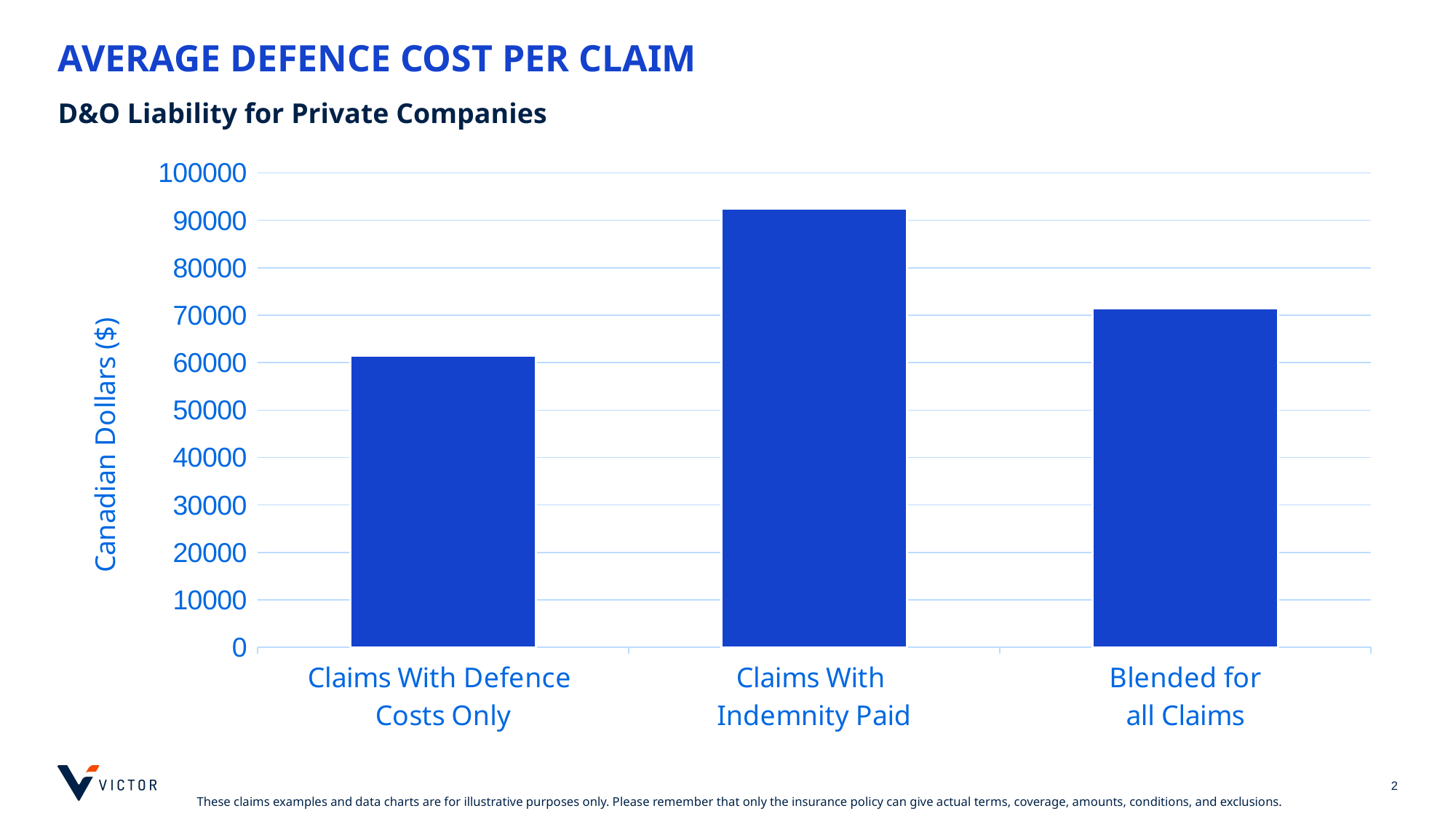
Which category has the lowest average defence cost per claim? Claims With Defence Costs Only Which is larger: the value for Blended for all Claims or the value for Claims With Defence Costs Only? Blended for all Claims What is the title of the chart on the slide? AVERAGE DEFENCE COST PER CLAIM Is the value for Claims With Indemnity Paid greater or less than 80000? greater Which is larger: the value for Claims With Indemnity Paid or the value for Blended for all Claims? Claims With Indemnity Paid Which category has the highest average defence cost per claim? Claims With Indemnity Paid Is the value for Claims With Defence Costs Only greater or less than 70000? less How many categories are plotted in the chart? 3 What is the label of the vertical axis? Canadian Dollars ($) Is the value for Blended for all Claims greater or less than 80000? less What kind of chart is shown on the slide? bar chart